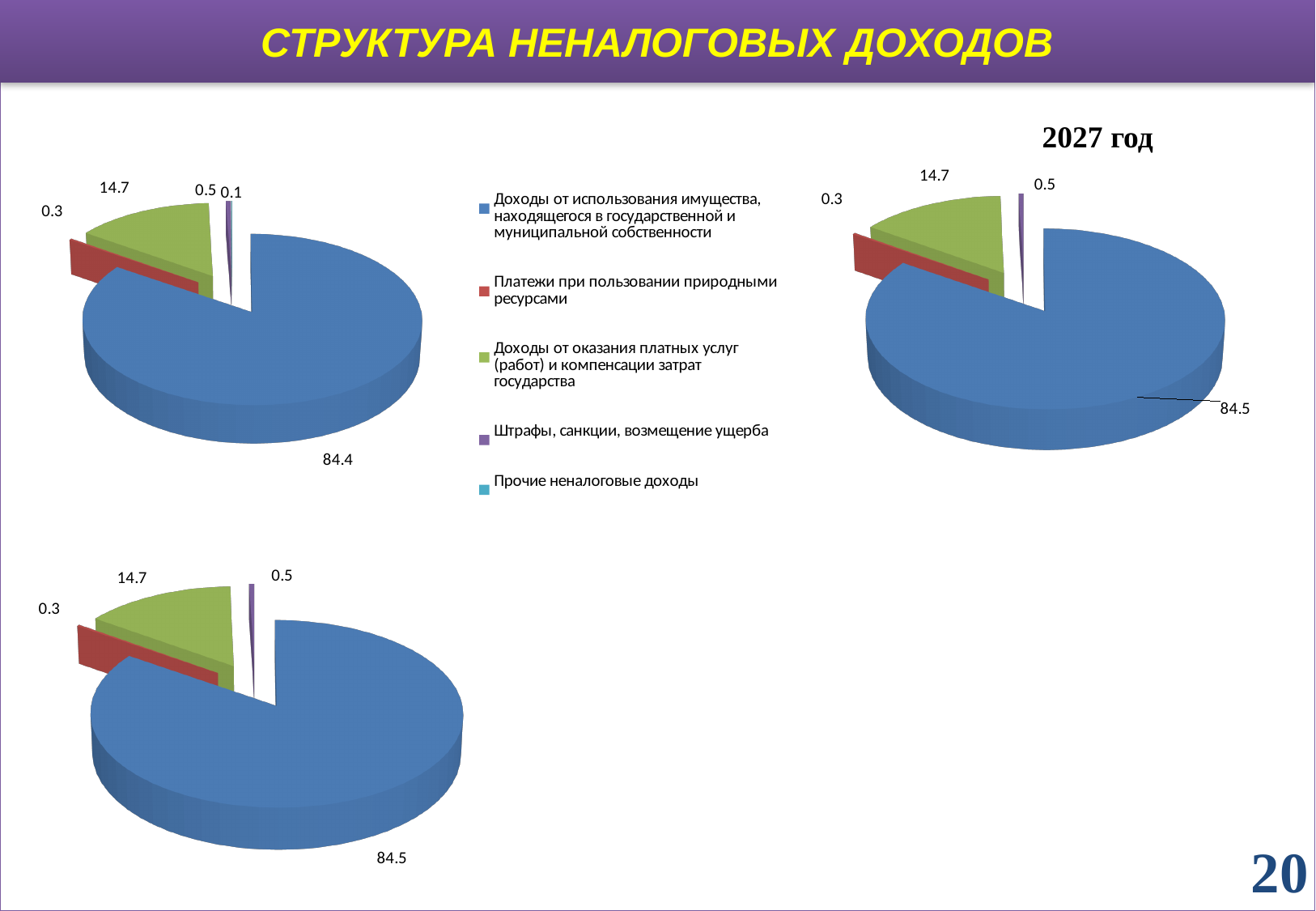
How many pie charts are shown on the slide? 3 On the pie chart titled '2027 год', what is the value of the blue slice (Доходы от использования имущества)? 84.5 What type of chart is the chart titled '2027 год'? Pie chart On the top-left pie chart, what is the value labelled for Прочие неналоговые доходы? 0.1 On the top-left pie chart, what is the value of the largest slice (Доходы от использования имущества, находящегося в государственной и муниципальной собственности)? 84.4 On the pie chart titled '2027 год', which category has the largest share? Доходы от использования имущества, находящегося в государственной и муниципальной собственности On the pie chart titled '2027 год', which is larger: the slice for Штрафы, санкции, возмещение ущерба or the slice for Платежи при пользовании природными ресурсами? Штрафы, санкции, возмещение ущерба On the bottom-left pie chart, what is the value of the green slice (Доходы от оказания платных услуг (работ) и компенсации затрат государства)? 14.7 On the bottom-left pie chart, what is the difference between the blue slice (84.5) and the green slice (14.7)? 69.8 On the top-left pie chart, what is the value of the red slice (Платежи при пользовании природными ресурсами)? 0.3 On the top-left pie chart, which category has the smallest share? Прочие неналоговые доходы How many entries does the legend list? 5